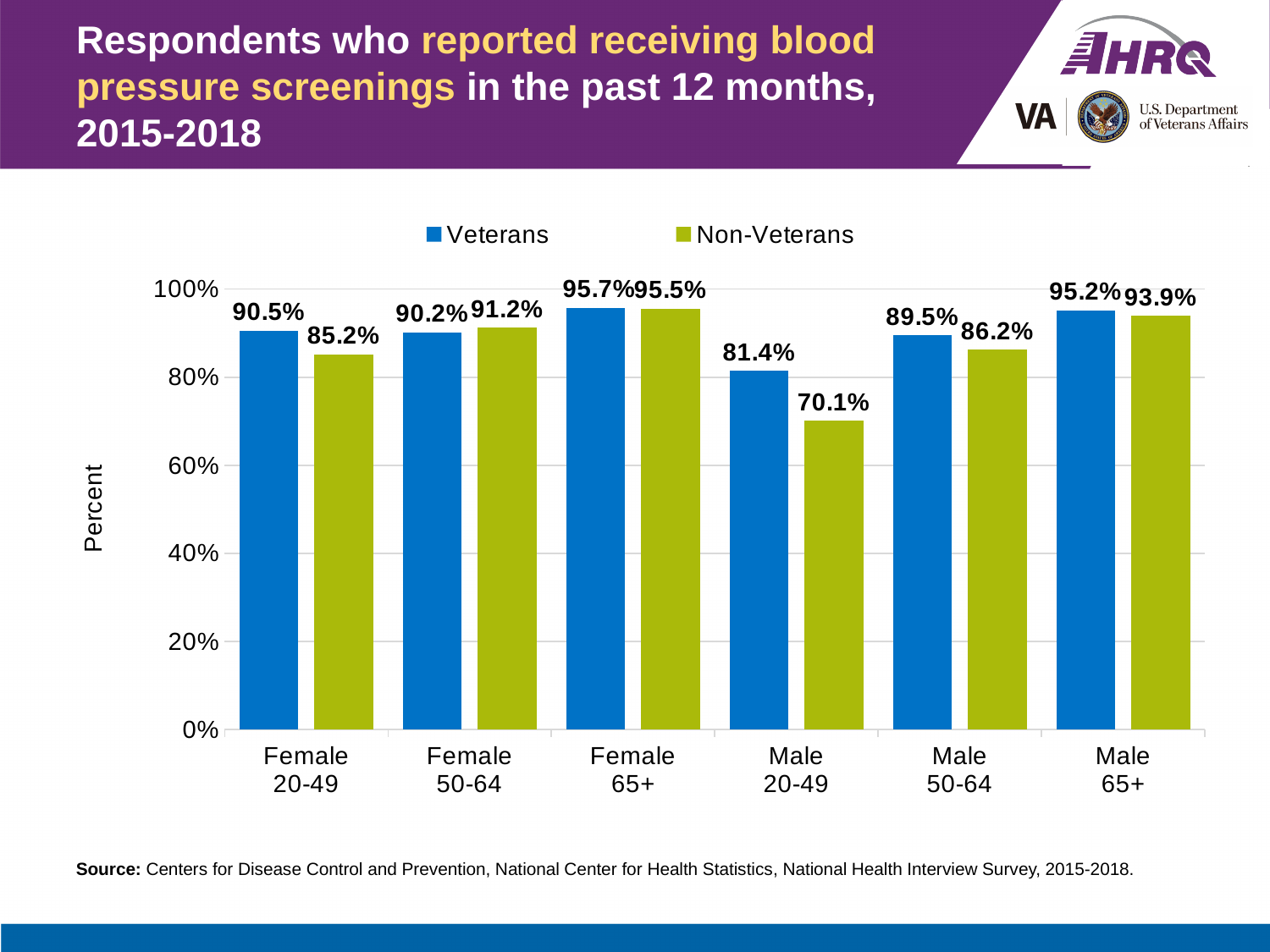
Which group has the lowest Non-Veterans value? Male 20-49 What is the difference between the Veterans and Non-Veterans values for Male 20-49? 11.3% How many groups are shown on the x axis? 6 What is the difference between the Veterans and Non-Veterans values for Female 20-49? 5.3% How many series does the legend list? 2 Which is larger for Male 50-64: the Veterans value or the Non-Veterans value? Veterans What is the value for Veterans in the Female 65+ group? 95.7% What kind of chart is shown on the slide? Bar chart Which group has the highest Veterans value? Female 65+ What percentage of female Veterans aged 20-49 reported receiving blood pressure screenings? 90.5% What is the value for Non-Veterans in the Male 20-49 group? 70.1% Is the Non-Veterans value for Male 20-49 greater or less than 80%? less